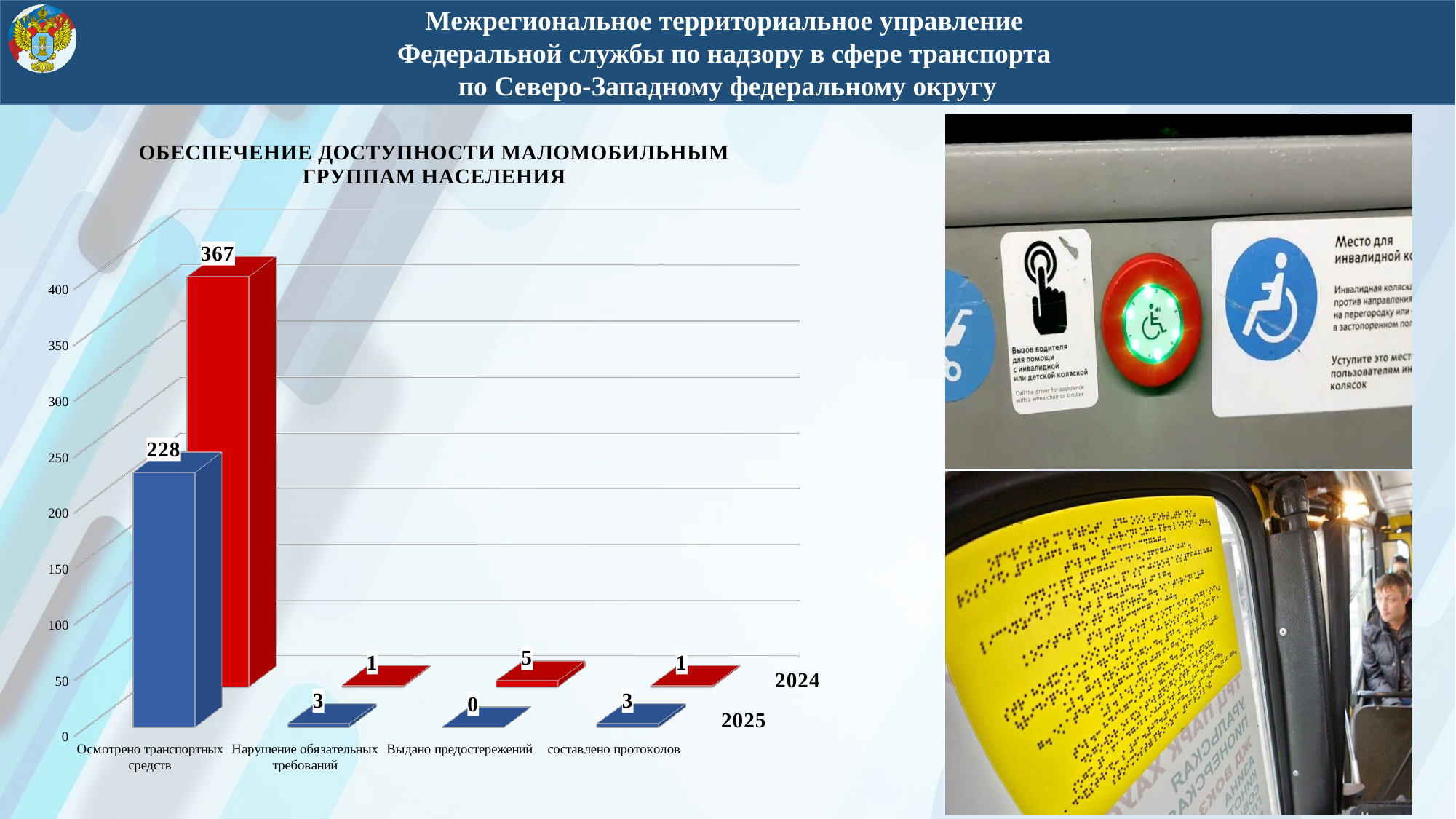
How many categories are shown on the x axis of the chart? 4 What kind of chart is shown on the slide? Bar chart What is the value for "Осмотрено транспортных средств" in 2025? 228 What is the value for "Выдано предостережений" in 2024? 5 Which is larger for "Выдано предостережений": the 2024 value or the 2025 value? 2024 What is the title of the chart? ОБЕСПЕЧЕНИЕ ДОСТУПНОСТИ МАЛОМОБИЛЬНЫМ ГРУППАМ НАСЕЛЕНИЯ What is the value for "Нарушение обязательных требований" in 2025? 3 What is the value for "составлено протоколов" in 2024? 1 What is the value for "Осмотрено транспортных средств" in 2024? 367 Which category has the lowest value in 2025? Выдано предостережений What is the difference between the 2024 and 2025 values for "Осмотрено транспортных средств"? 139 Which category has the highest value in 2024? Осмотрено транспортных средств